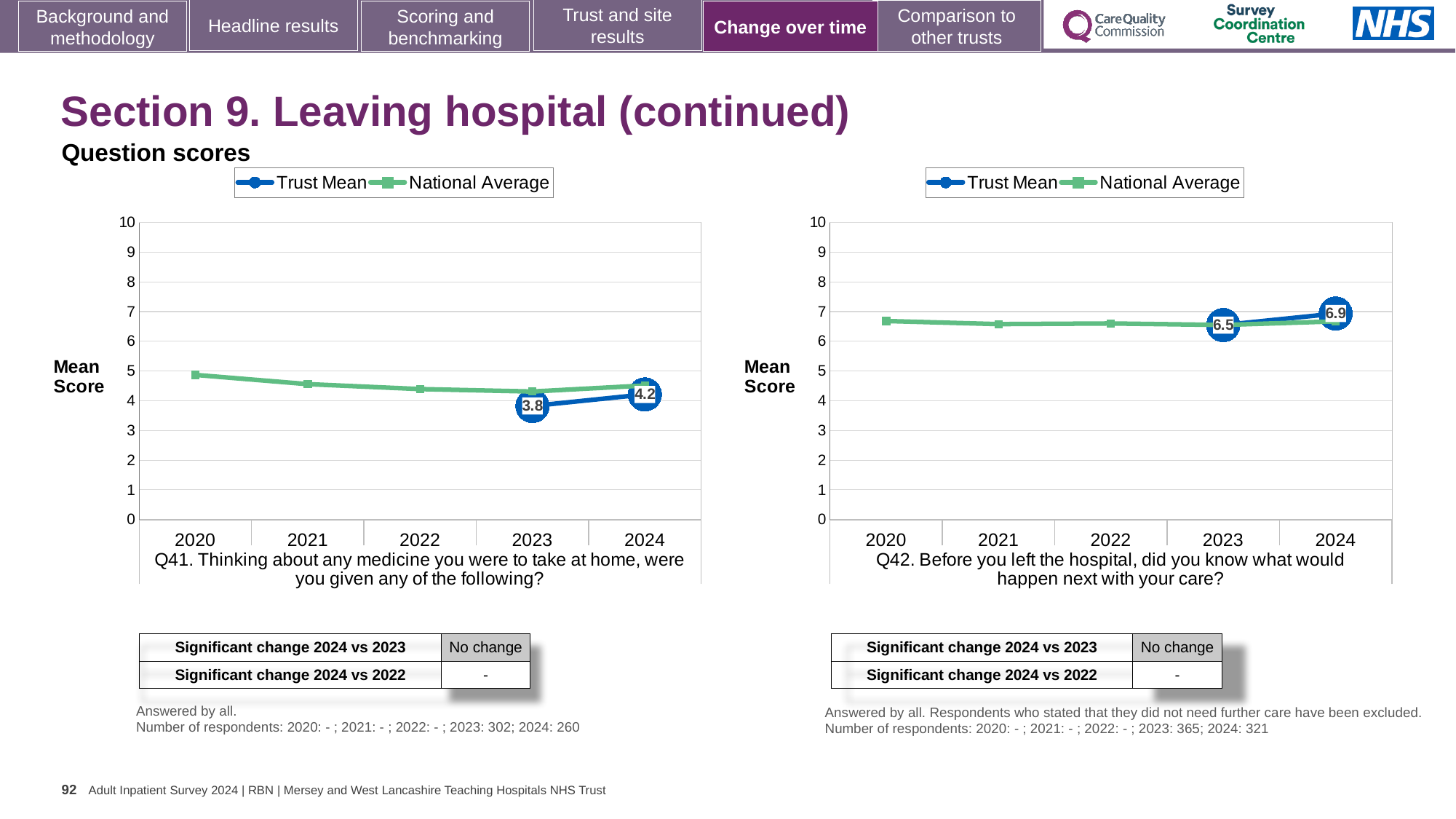
In the Q42 chart on the right, what is the Trust Mean value for 2023? 6.5 In the Q41 chart on the left, which year has the higher Trust Mean, 2023 or 2024? 2024 In the Q42 chart on the right, what is the difference between the Trust Mean in 2024 and in 2023? 0.4 How many series does the legend of the Q42 chart on the right list? 2 In the Q42 chart on the right, is the National Average for 2020 greater or less than 6? greater In the Q41 chart on the left, what is the Trust Mean value for 2023? 3.8 In the Q42 chart on the right, what is the Trust Mean value for 2024? 6.9 What kind of chart is the Q41 chart on the left? line chart In the Q42 chart on the right, does the Trust Mean rise or fall from 2023 to 2024? rise In the Q41 chart on the left, by how much did the Trust Mean change from 2023 to 2024? 0.4 In the Q41 chart on the left, is the National Average for 2021 greater or less than 5? less In the Q41 chart on the left, what is the Trust Mean value for 2024? 4.2